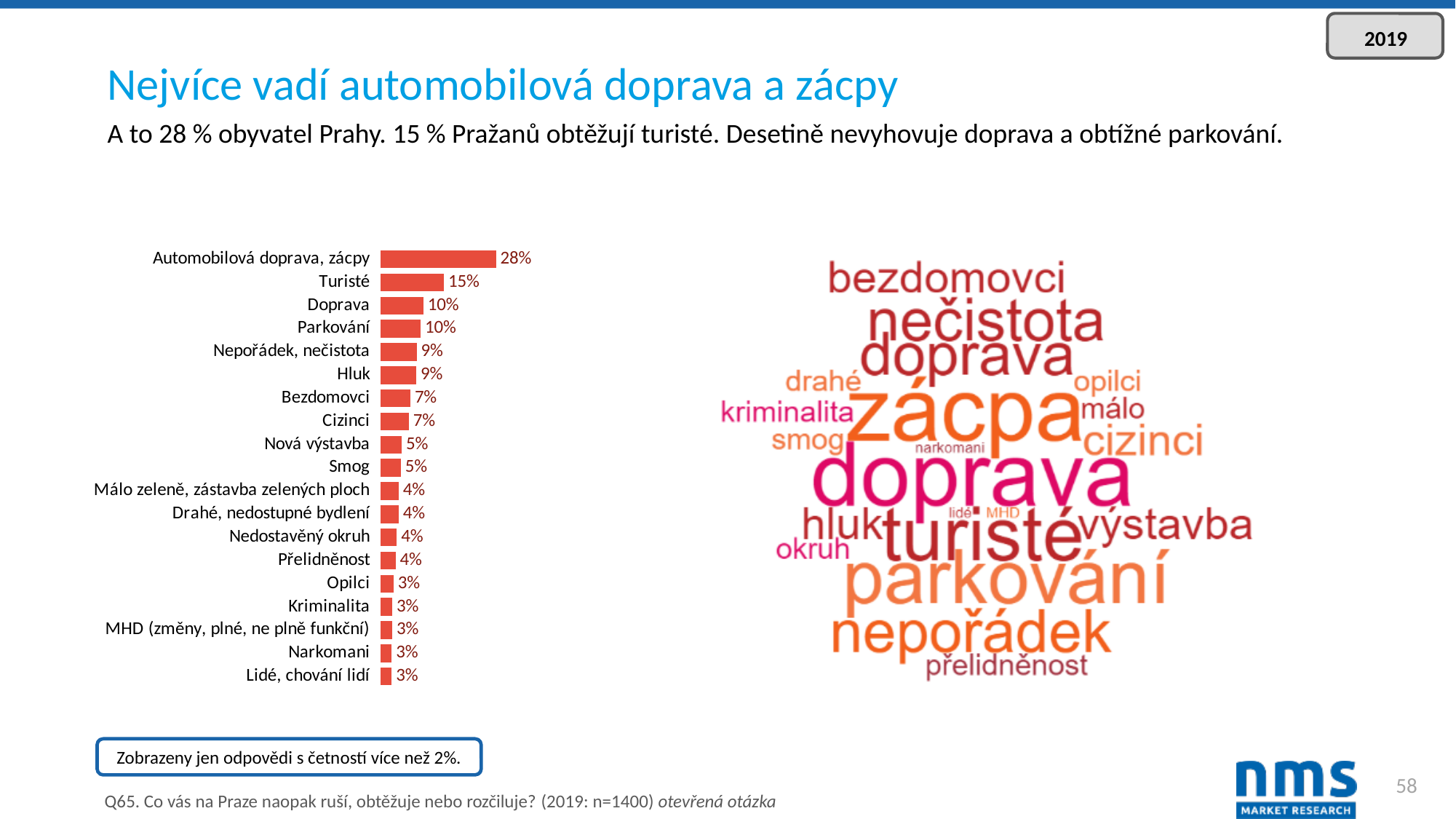
Which has a larger value, Cizinci or Nová výstavba? Cizinci What value is shown for Bezdomovci in the bar chart? 7% What value is shown for Hluk in the bar chart? 9% How many categories are shown in the bar chart? 19 What kind of chart is shown on the left of the slide? Bar chart What value is shown for Nedostavěný okruh in the bar chart? 4% Which has a larger value, Opilci or Nepořádek, nečistota? Nepořádek, nečistota What is the difference between the values for Doprava and Smog? 5% What is the value shown for Parkování in the bar chart? 10% What value is shown for Turisté in the bar chart? 15% What is the difference between the values for Automobilová doprava, zácpy and Turisté? 13% Which category has the highest value in the bar chart? Automobilová doprava, zácpy